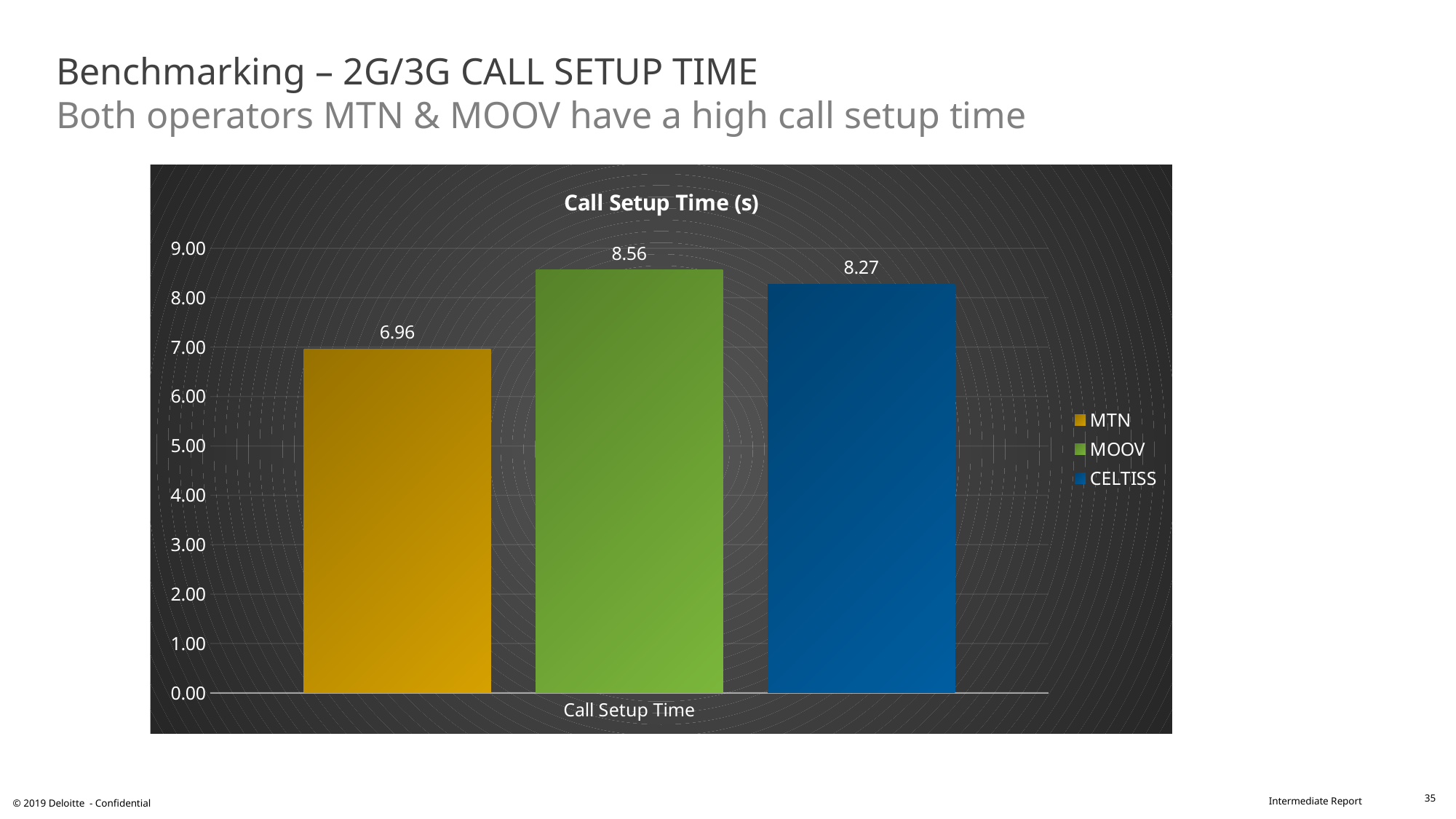
What kind of chart is shown on the slide? bar chart What is the call setup time for MTN? 6.96 How many series does the legend list? 3 What is the call setup time for MOOV? 8.56 Which operator has the lowest call setup time? MTN What is the call setup time for CELTISS? 8.27 What is the difference between the call setup times of MOOV and CELTISS? 0.29 What is the title of the chart? Call Setup Time (s) Which operator has the highest call setup time? MOOV Which has a larger call setup time, CELTISS or MTN? CELTISS What is the difference between the call setup times of MOOV and MTN? 1.60 Is the call setup time for MTN greater or less than 7.00? less